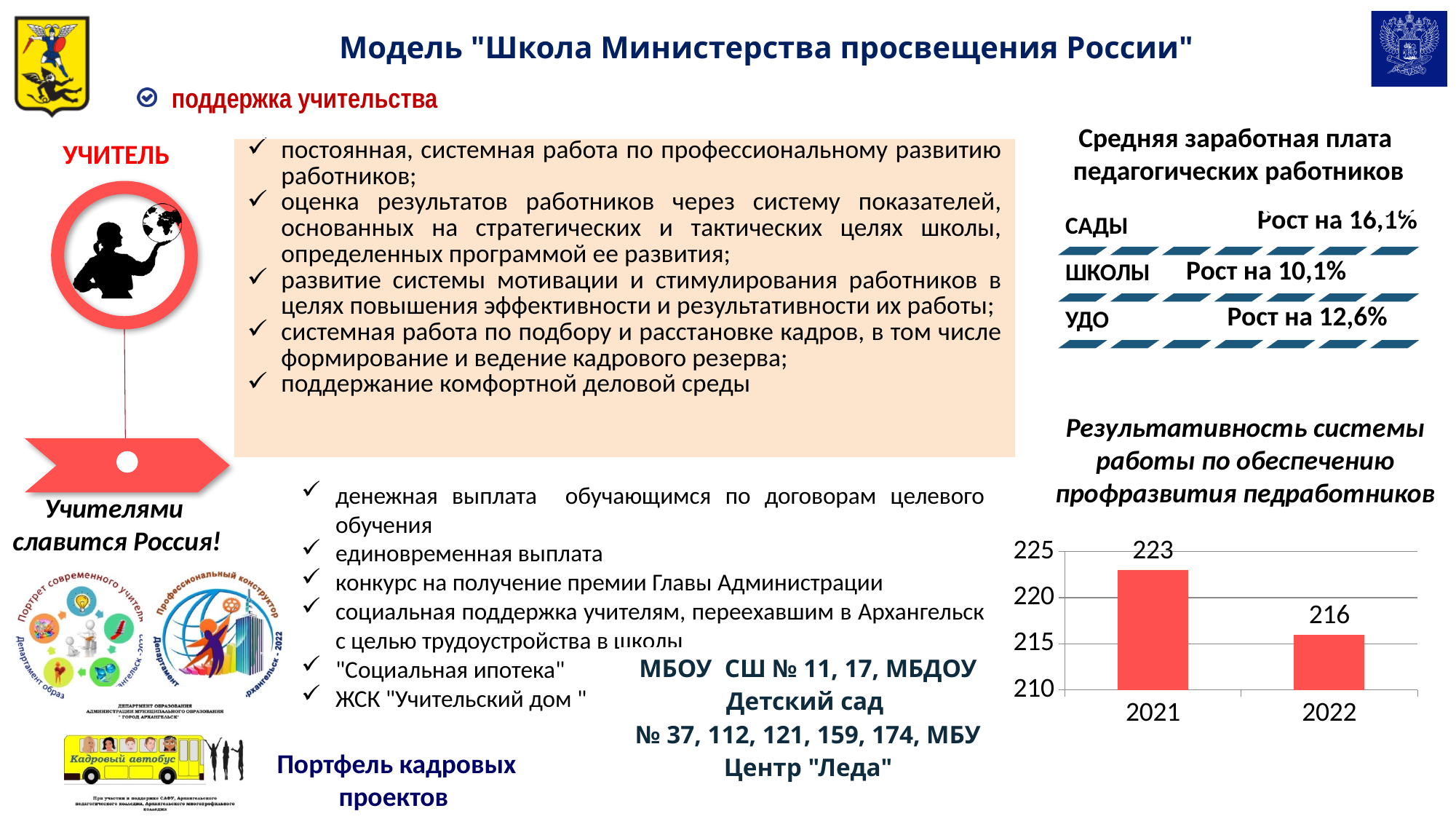
What is the difference between the values for 2021 and 2022 in the bar chart? 7 How many years are shown in the bar chart? 2 What kind of chart is shown on the slide? bar chart Which is larger in the bar chart, the value for 2021 or the value for 2022? 2021 Is the value for 2021 in the bar chart greater or less than 220? greater What is the value for 2022 in the bar chart? 216 What is the title of the bar chart? Результативность системы работы по обеспечению профразвития педработников Which year has the highest value in the bar chart? 2021 Do the values in the bar chart rise or fall from 2021 to 2022? fall Is the value for 2022 in the bar chart greater or less than 220? less Which year has the lowest value in the bar chart? 2022 What is the value for 2021 in the bar chart? 223